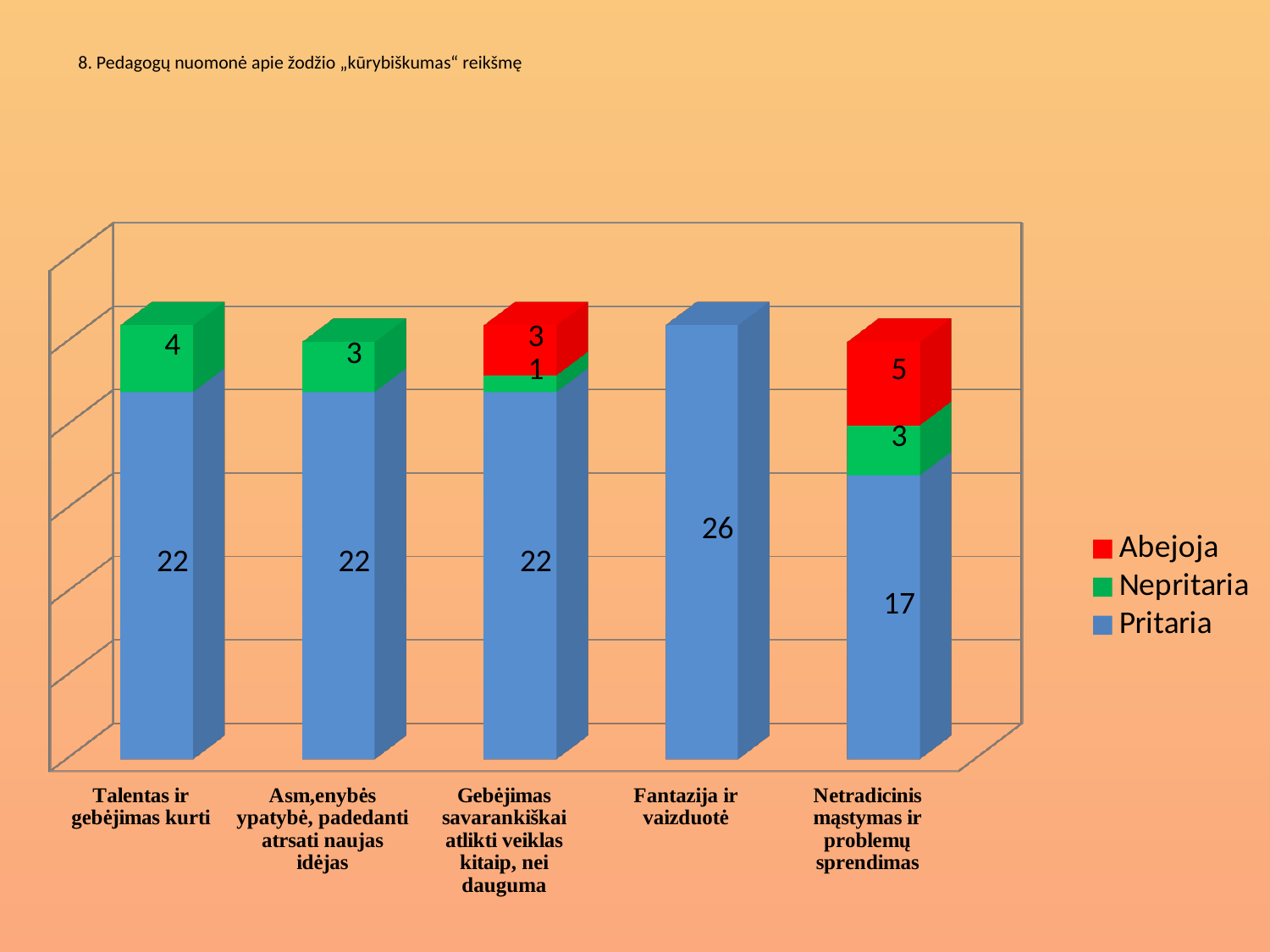
What is the Pritaria value for "Fantazija ir vaizduotė"? 26 Which colour represents the Abejoja series in the legend? red How many categories are shown on the x axis? 5 What is the difference between the Pritaria values for "Fantazija ir vaizduotė" and "Netradicinis mąstymas ir problemų sprendimas"? 9 Which category has the highest Pritaria value? Fantazija ir vaizduotė How many series does the legend list? 3 What is the total of the stacked bar for "Netradicinis mąstymas ir problemų sprendimas"? 25 What is the Pritaria value for "Netradicinis mąstymas ir problemų sprendimas"? 17 Which category has the lowest Pritaria value? Netradicinis mąstymas ir problemų sprendimas What is the Nepritaria value for "Talentas ir gebėjimas kurti"? 4 What is the Abejoja value for "Netradicinis mąstymas ir problemų sprendimas"? 5 What type of chart is shown on the slide? bar chart